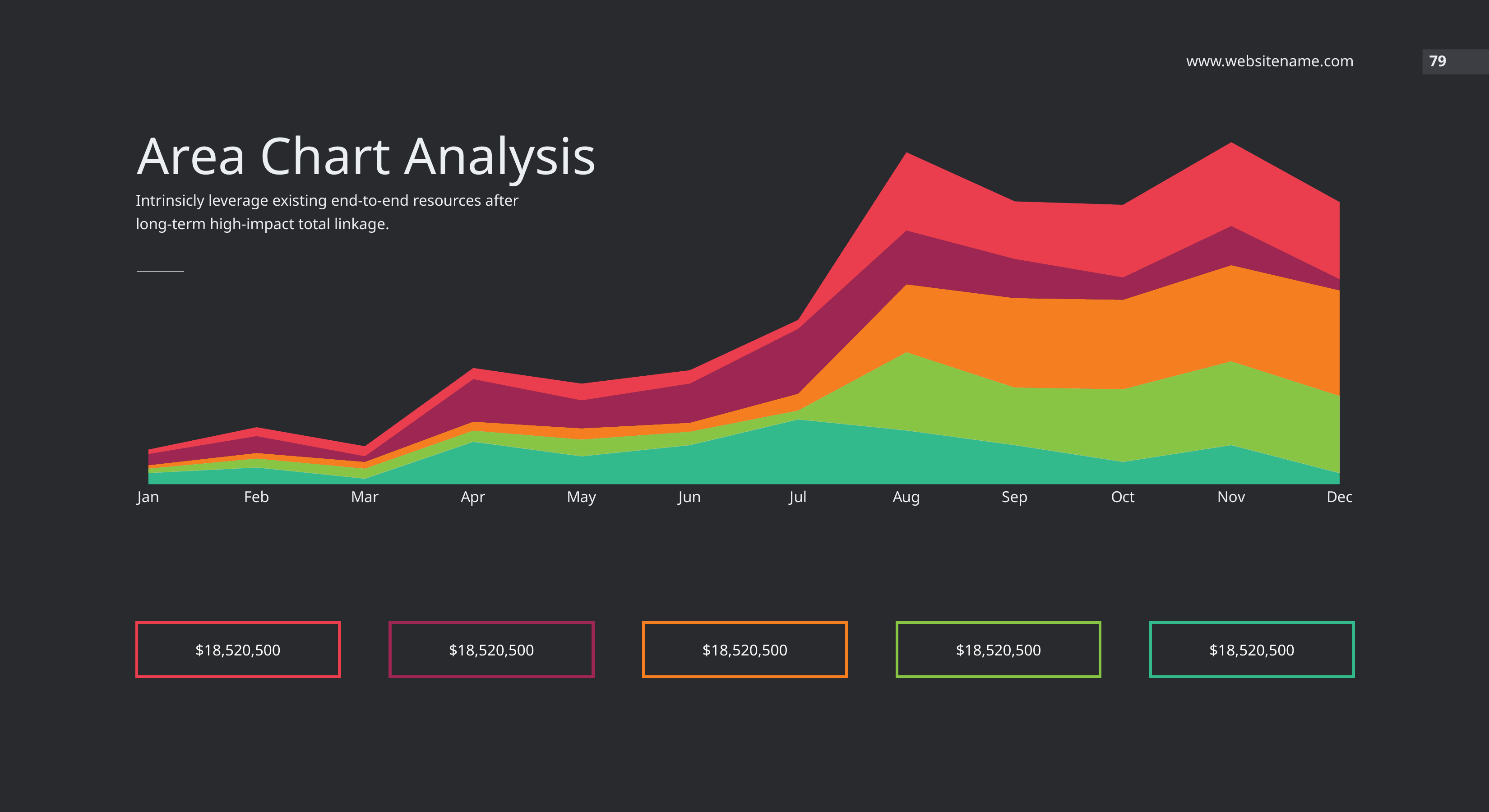
What kind of chart is shown on the slide? Area chart What value is printed in each of the five boxes below the chart? $18,520,500 Is the stacked total larger in Feb or in Jul? Jul What is the title of the chart slide? Area Chart Analysis In which month does the bottom teal layer reach its highest point? Jul Do the stacked totals generally rise or fall from Jan to Dec? Rise Which is the first month shown on the x axis? Jan Is the stacked total larger in Aug or in Apr? Aug How many months are shown along the x axis of the area chart? 12 Which is the last month shown on the x axis? Dec Is the stacked total larger in Mar or in Sep? Sep How many coloured stacked layers does the area chart have? 5